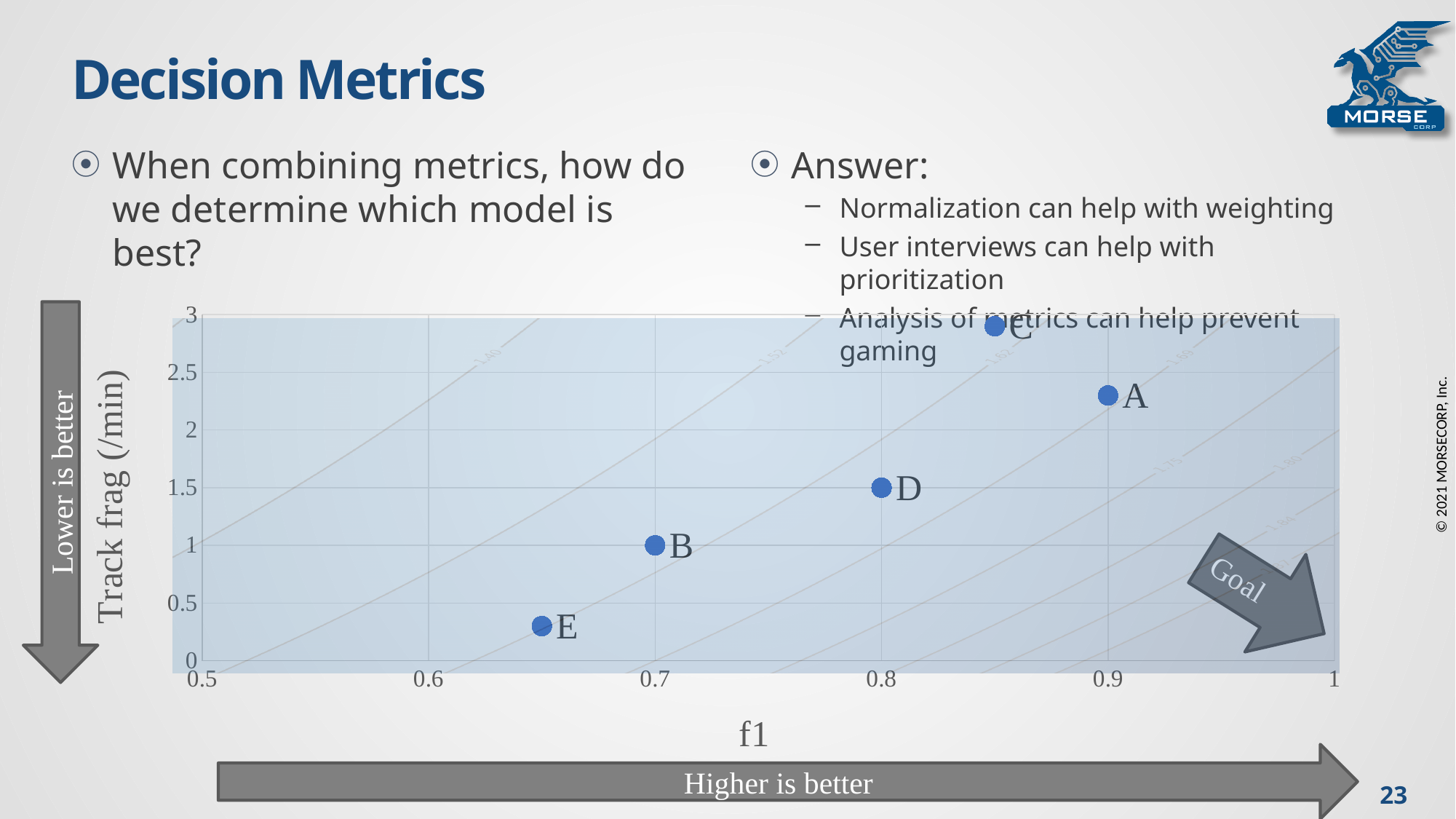
Which point has the lowest Track frag (/min) value? E Which point has a higher Track frag (/min) value, D or B? D Is the Track frag (/min) value for point A greater or less than 2? greater Which point has the highest Track frag (/min) value? C What is the title of the x axis of the chart? f1 What is the f1 value of point D? 0.8 What is the title of the y axis of the chart? Track frag (/min) Which point has the lowest f1 value? E What is the f1 value of point B? 0.7 How many labelled points are plotted on the chart? 5 Which point has the highest f1 value? A What kind of chart is shown on the slide? scatter chart